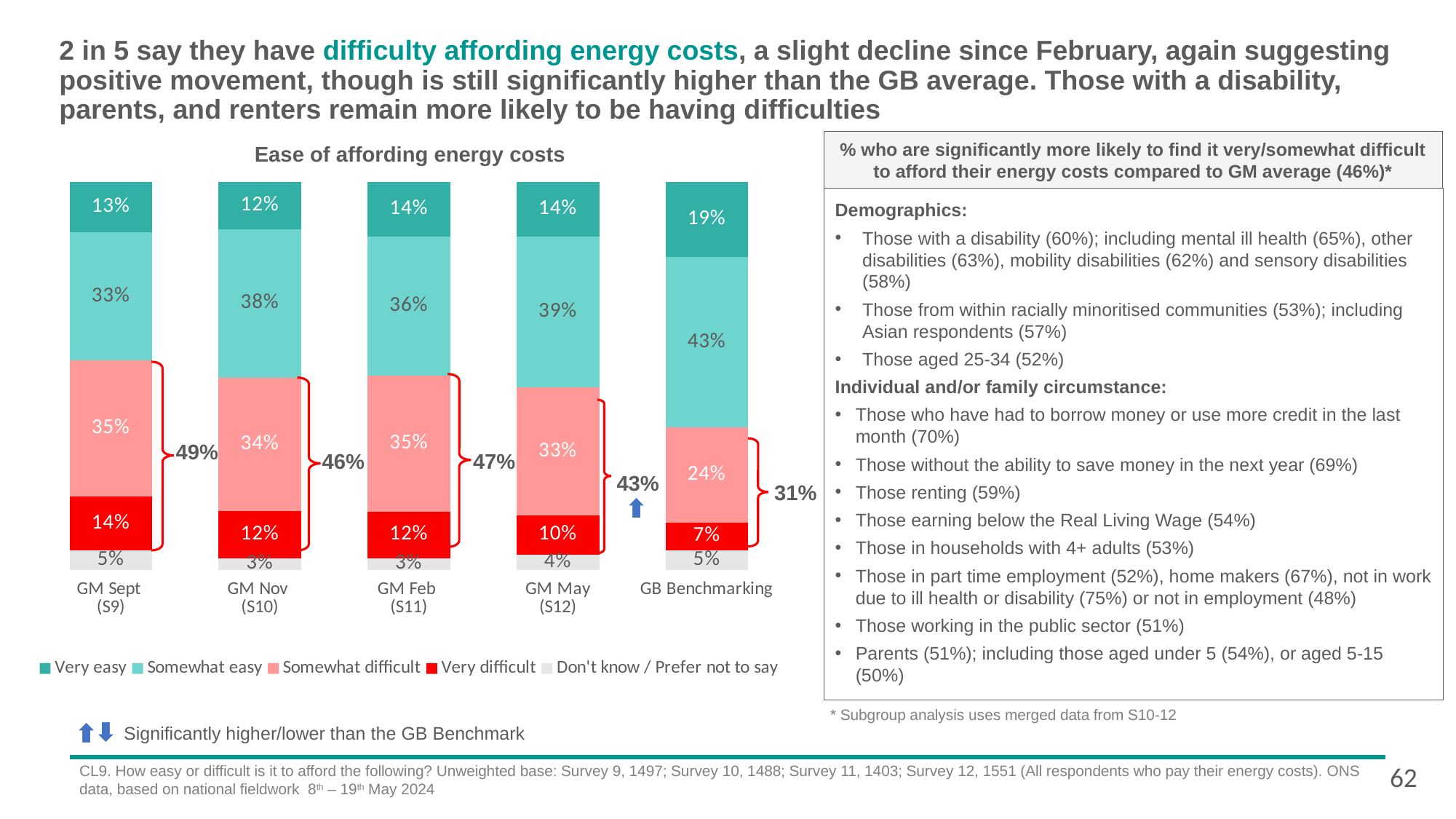
Which category has the highest 'Very easy' value? GB Benchmarking What is the 'Very difficult' value for GM Sept (S9)? 14% What is the difference between the 'Somewhat difficult' values for GM Feb (S11) and GB Benchmarking? 11% How many categories (bars) are shown on the x axis of the chart? 5 What type of chart is used to show ease of affording energy costs? Stacked bar chart What is the 'Somewhat easy' value for GB Benchmarking? 43% Which category has the lowest 'Very difficult' value? GB Benchmarking What is the title of the chart? Ease of affording energy costs What is the 'Very easy' value for GM Nov (S10)? 12% Which is larger: the 'Somewhat easy' value for GM May (S12) or for GM Sept (S9)? GM May (S12) What is the combined 'Somewhat difficult' and 'Very difficult' share shown by the bracket for GM May (S12)? 43% How many series does the chart legend list? 5